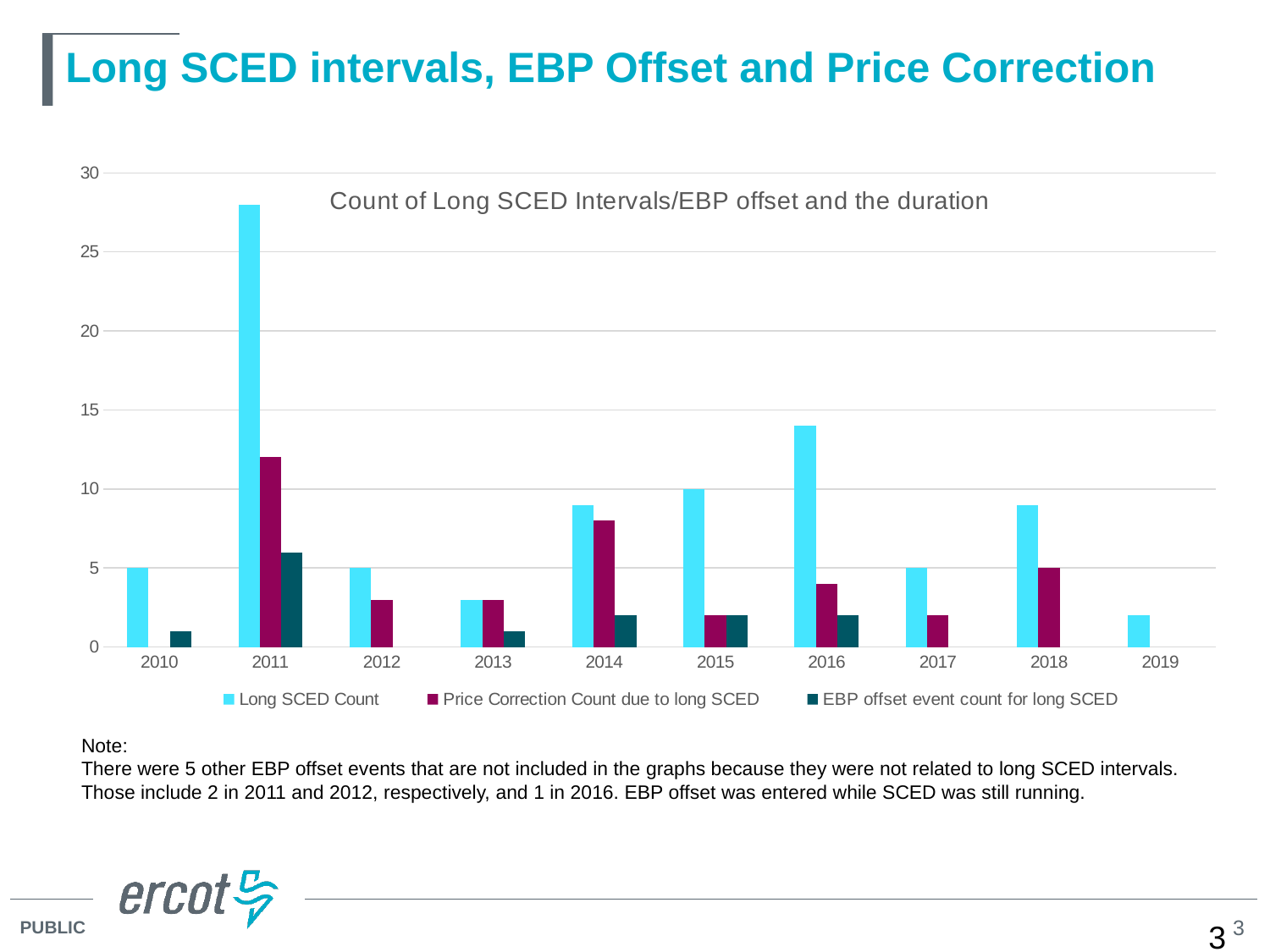
Is the Long SCED Count for 2011 greater or less than 25? greater How many years are shown on the x axis? 10 What is the Long SCED Count for 2010? 5 Is the Price Correction Count due to long SCED for 2011 greater or less than 10? greater Which is larger, the Long SCED Count for 2011 or for 2016? 2011 What is the Long SCED Count for 2015? 10 Is the Long SCED Count for 2016 greater or less than 10? greater How many series does the legend list? 3 What kind of chart is shown on the slide? bar chart Which year has the highest Long SCED Count? 2011 What is the title of the chart? Count of Long SCED Intervals/EBP offset and the duration Which series is shown in the dark teal colour? EBP offset event count for long SCED